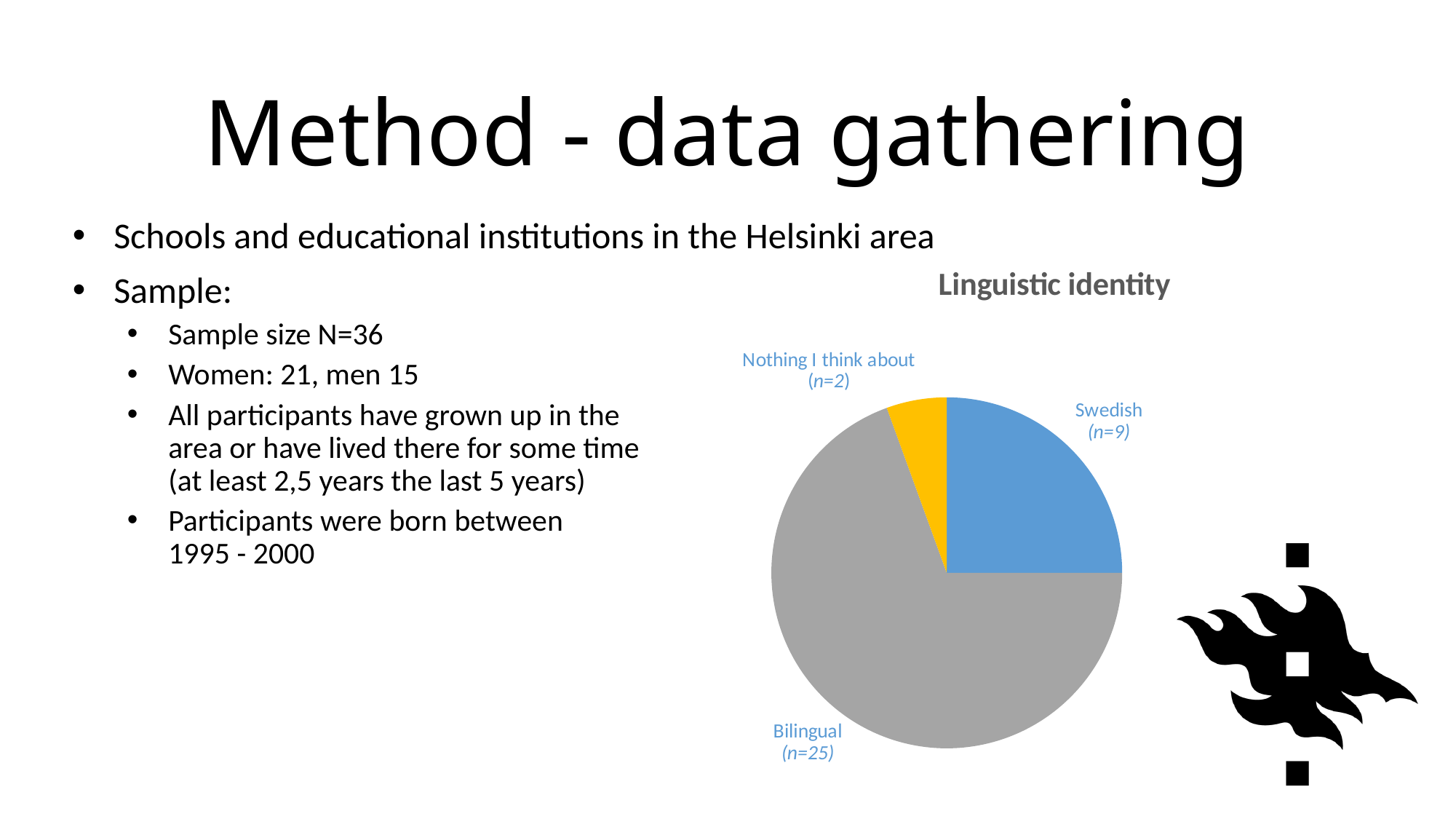
What is the n value for the 'Nothing I think about' slice? 2 What type of chart is shown on the slide? pie chart What is the n value for the Swedish slice? 9 What is the n value for the Bilingual slice? 25 How many more participants are Bilingual than Swedish? 16 What is the difference in n between Swedish and 'Nothing I think about'? 7 Which is larger, the Swedish slice or the 'Nothing I think about' slice? Swedish What is the title of the chart? Linguistic identity What share of the pie does the Swedish slice represent? 25% Which category has the smallest slice in the pie chart? Nothing I think about How many slices does the Linguistic identity pie chart have? 3 Which category has the largest slice in the pie chart? Bilingual